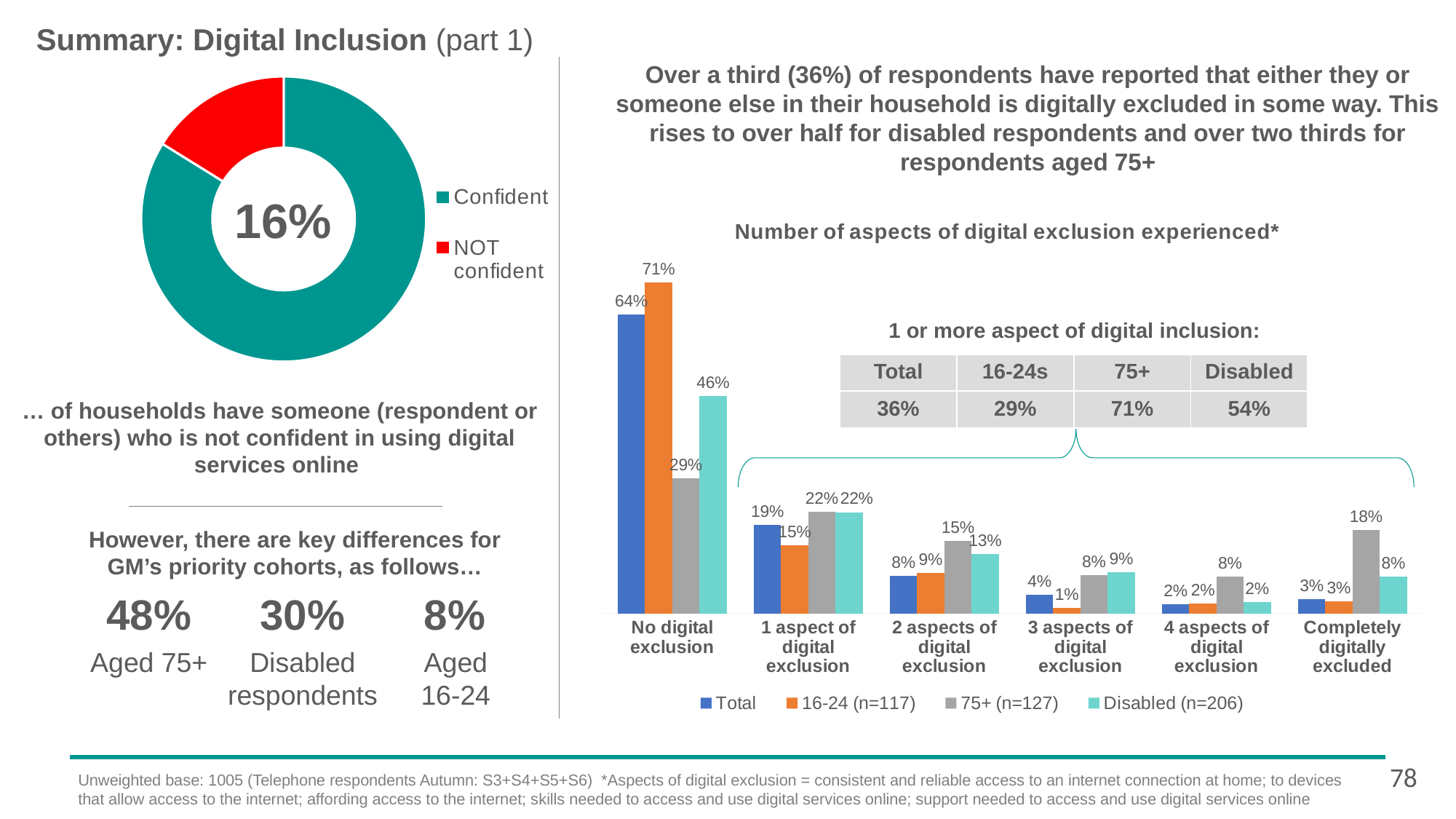
In the donut chart on the left of the slide, what share does the 'NOT confident' slice represent? 16% How many series does the legend of the bar chart 'Number of aspects of digital exclusion experienced' list? 4 In the bar chart 'Number of aspects of digital exclusion experienced', what colour represents the Total series? Blue In the bar chart 'Number of aspects of digital exclusion experienced', what is the value for the Total series in the 'No digital exclusion' category? 64% In the bar chart 'Number of aspects of digital exclusion experienced', which series has the lowest value in the '3 aspects of digital exclusion' category? 16-24 (n=117) In the bar chart 'Number of aspects of digital exclusion experienced', which series has the highest value in the 'No digital exclusion' category? 16-24 (n=117) In the bar chart 'Number of aspects of digital exclusion experienced', what is the difference between the 16-24 (n=117) and 75+ (n=127) values in the 'No digital exclusion' category? 42% How many categories are shown on the x axis of the bar chart 'Number of aspects of digital exclusion experienced'? 6 In the bar chart 'Number of aspects of digital exclusion experienced', what is the value for the Disabled (n=206) series in the '2 aspects of digital exclusion' category? 13% In the bar chart 'Number of aspects of digital exclusion experienced', which is larger in the '2 aspects of digital exclusion' category: the 75+ (n=127) value or the Disabled (n=206) value? 75+ (n=127) In the bar chart 'Number of aspects of digital exclusion experienced', what is the value for the 75+ (n=127) series in the 'Completely digitally excluded' category? 18% What kind of chart is the chart on the left of the slide with the 'Confident' and 'NOT confident' legend? Donut chart